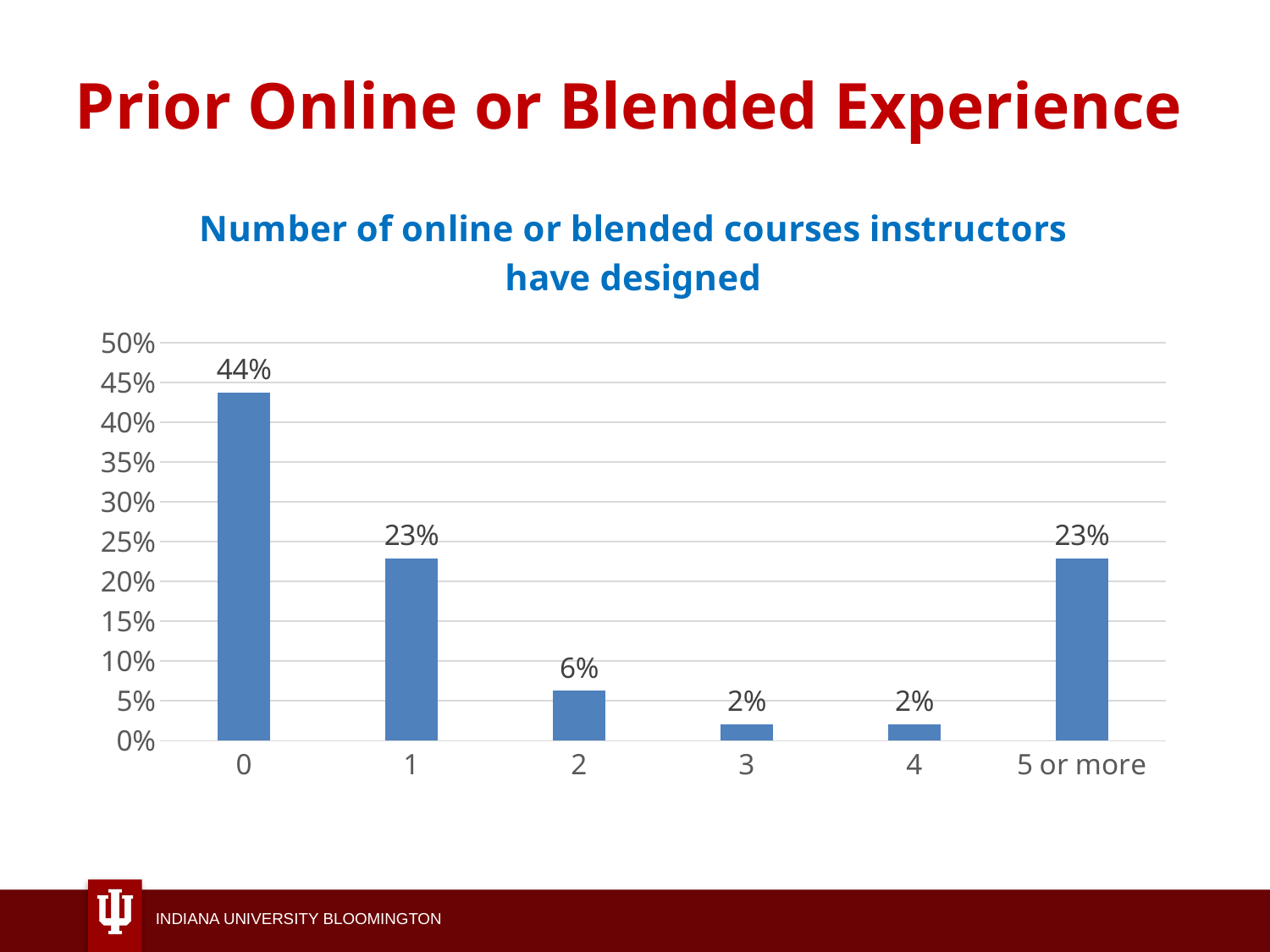
What is the difference between the values for 2 courses and 3 courses? 4% What percentage of instructors have designed 0 online or blended courses? 44% What is the highest value shown on the y axis? 50% What kind of chart is shown on the slide? bar chart What is the title of the chart? Number of online or blended courses instructors have designed What percentage of instructors have designed 2 online or blended courses? 6% What is the difference between the values for 0 courses and 1 course? 21% What is the value for the '5 or more' category? 23% How many categories are shown on the x axis? 6 Which category has the highest value? 0 Is the value for 0 courses greater or less than 40%? greater Which is larger, the value for 1 course or the value for 2 courses? 1 course